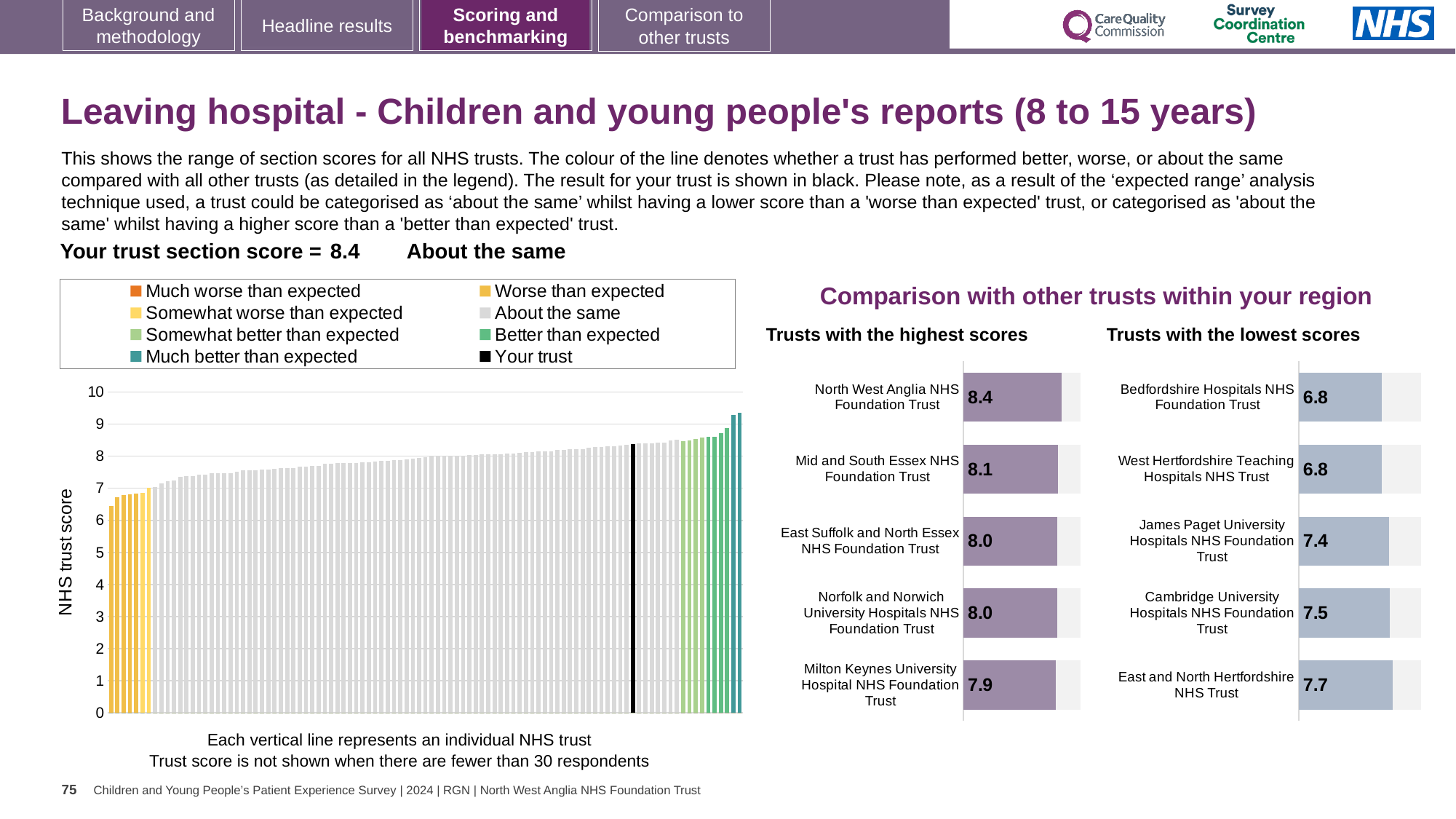
How many trusts are shown in the 'Trusts with the highest scores' chart? 5 In the main NHS trust score chart, is the value of the leftmost (lowest) bar greater or less than 7? less What kind of chart is the main chart showing the NHS trust scores for all trusts? Bar chart In the 'Trusts with the highest scores' chart, what is the score for Mid and South Essex NHS Foundation Trust? 8.1 In the 'Trusts with the highest scores' chart, which trust has the highest score? North West Anglia NHS Foundation Trust What is the y-axis label of the main NHS trust score chart? NHS trust score In the 'Trusts with the lowest scores' chart, which has the larger score: Cambridge University Hospitals NHS Foundation Trust or James Paget University Hospitals NHS Foundation Trust? Cambridge University Hospitals NHS Foundation Trust In the 'Trusts with the lowest scores' chart, what is the score for James Paget University Hospitals NHS Foundation Trust? 7.4 In the 'Trusts with the highest scores' chart, what is the difference between the scores of North West Anglia NHS Foundation Trust and Milton Keynes University Hospital NHS Foundation Trust? 0.5 How many entries does the legend of the main NHS trust score chart list? 8 In the 'Trusts with the lowest scores' chart, which trust has the highest score? East and North Hertfordshire NHS Trust In the main NHS trust score chart, do the values rise or fall from left to right? Rise